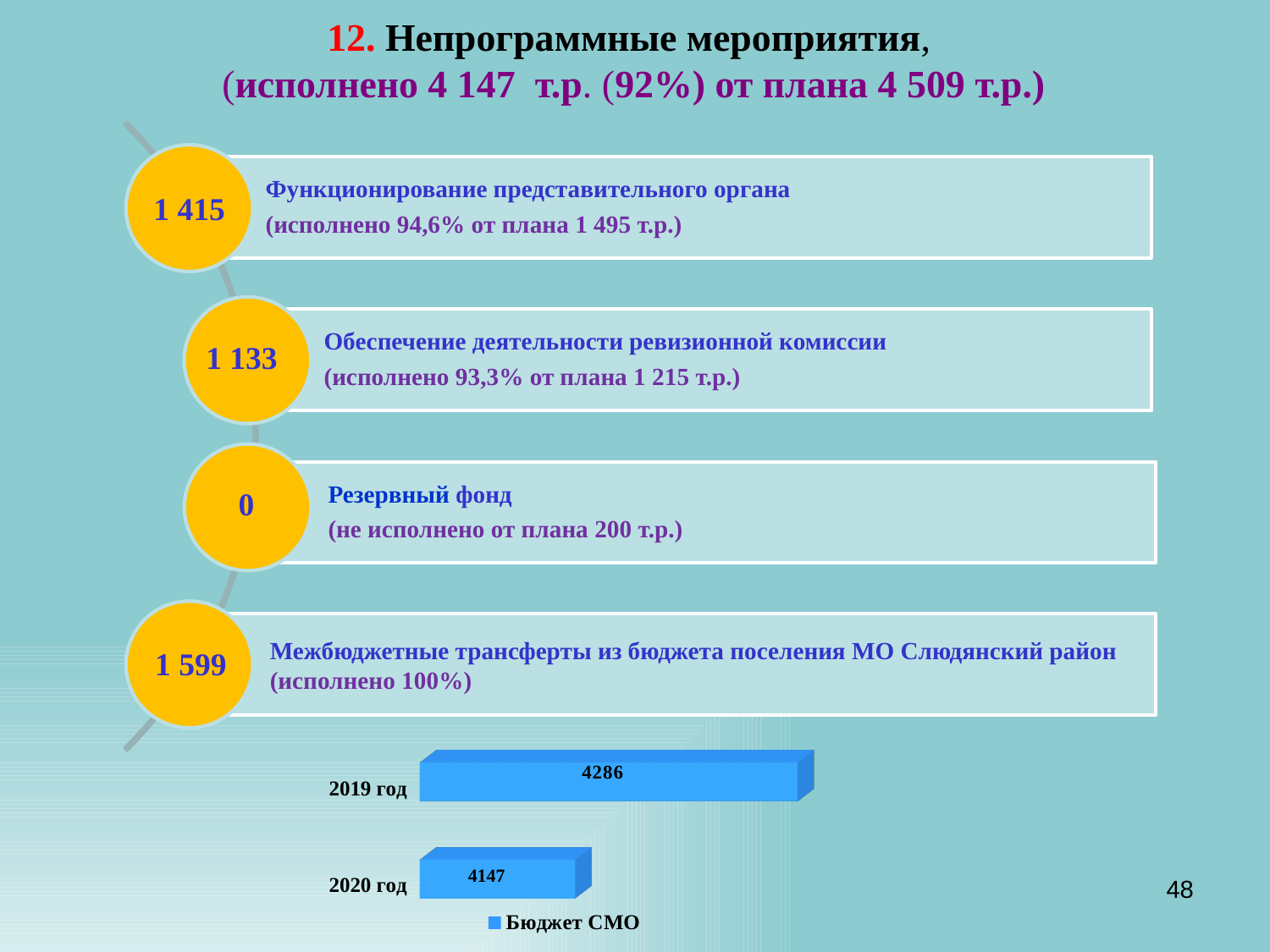
What is the value for 2020 год in the bar chart? 4147 Does the value rise or fall from 2019 год to 2020 год in the bar chart? fall How many categories (years) are shown in the bar chart? 2 What kind of chart is shown at the bottom of the slide? bar chart Which year has the lower value in the bar chart? 2020 год How many series does the legend of the bar chart list? 1 What is the difference between the values for 2019 год and 2020 год in the bar chart? 139 What colour are the bars in the bar chart? blue Is the value for 2020 год larger or smaller than the value for 2019 год in the bar chart? smaller What is the name of the series in the bar chart's legend? Бюджет СМО Which year has the higher value in the bar chart? 2019 год What is the value for 2019 год in the bar chart? 4286